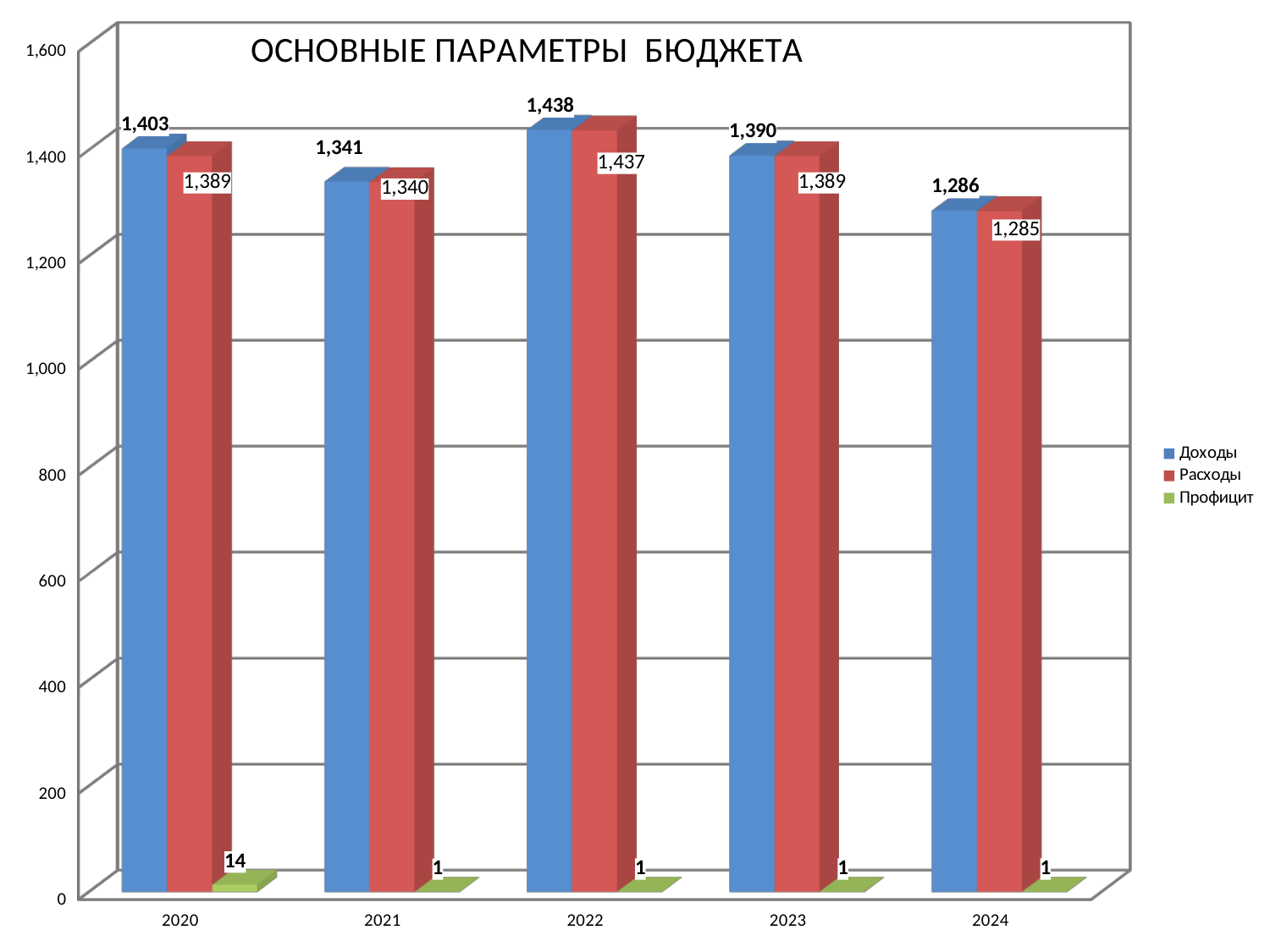
How many series does the legend list? 3 What is the value of Доходы for 2022? 1,438 Which is larger: Расходы in 2021 or Расходы in 2023? Расходы in 2023 What kind of chart is shown on the slide? Bar chart What is the value of Профицит for 2020? 14 Which year has the lowest Расходы value? 2024 What is the difference between Доходы and Расходы in 2020? 14 How many years are shown on the x axis? 5 What is the value of Расходы for 2024? 1,285 What is the title of the chart? ОСНОВНЫЕ ПАРАМЕТРЫ БЮДЖЕТА What is the difference between Доходы in 2022 and Доходы in 2024? 152 Which year has the highest Доходы value? 2022